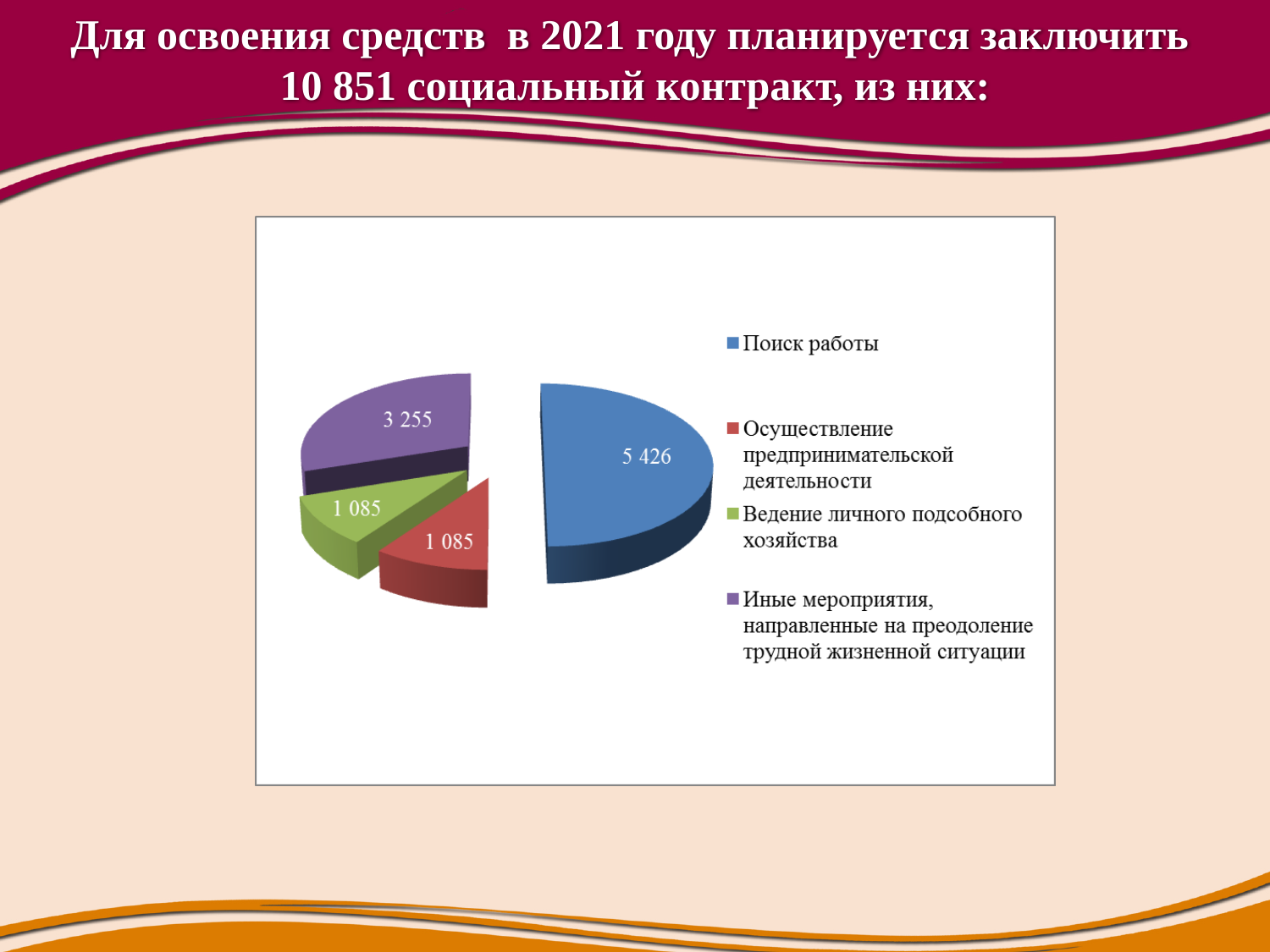
How many entries does the legend of the pie chart list? 4 What kind of chart is shown on the slide? pie chart What is the value for "Иные мероприятия, направленные на преодоление трудной жизненной ситуации" in the pie chart? 3 255 What share of the pie does "Поиск работы" represent? 50% What is the difference between the values for "Поиск работы" and "Иные мероприятия, направленные на преодоление трудной жизненной ситуации"? 2 171 How many slices does the pie chart have? 4 What is the value for "Поиск работы" in the pie chart? 5 426 What is the value for "Осуществление предпринимательской деятельности" in the pie chart? 1 085 Which is larger: the value for "Иные мероприятия, направленные на преодоление трудной жизненной ситуации" or the value for "Ведение личного подсобного хозяйства"? Иные мероприятия, направленные на преодоление трудной жизненной ситуации Which category has the largest slice in the pie chart? Поиск работы What is the value for "Ведение личного подсобного хозяйства" in the pie chart? 1 085 What colour is the slice for "Поиск работы" in the pie chart? blue